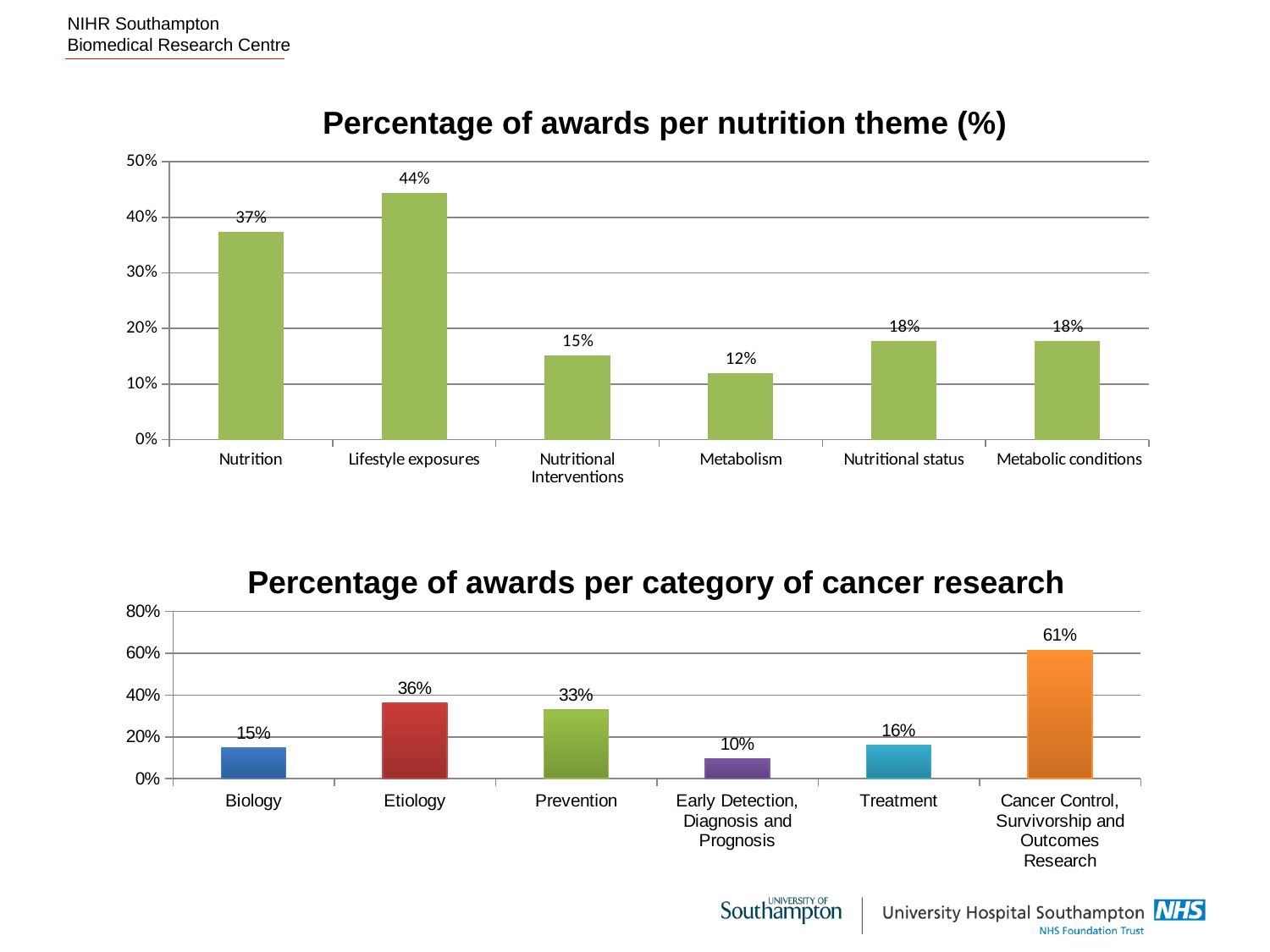
In the 'Percentage of awards per nutrition theme (%)' chart, how many themes are shown? 6 In the 'Percentage of awards per category of cancer research' chart, what is the value for Cancer Control, Survivorship and Outcomes Research? 61% In the 'Percentage of awards per category of cancer research' chart, what colour is the Etiology bar? Red In the 'Percentage of awards per nutrition theme (%)' chart, what is the value for Lifestyle exposures? 44% In the 'Percentage of awards per category of cancer research' chart, which category has the lowest percentage? Early Detection, Diagnosis and Prognosis In the 'Percentage of awards per category of cancer research' chart, which is larger, Etiology or Prevention? Etiology In the 'Percentage of awards per nutrition theme (%)' chart, what is the value for Nutritional status? 18% In the 'Percentage of awards per nutrition theme (%)' chart, which theme has the lowest percentage? Metabolism In the 'Percentage of awards per nutrition theme (%)' chart, which theme has the highest percentage? Lifestyle exposures In the 'Percentage of awards per nutrition theme (%)' chart, what is the difference between Nutrition and Nutritional Interventions? 22% What kind of chart is the 'Percentage of awards per category of cancer research' chart? Bar chart In the 'Percentage of awards per category of cancer research' chart, what is the difference between Cancer Control, Survivorship and Outcomes Research and Treatment? 45%